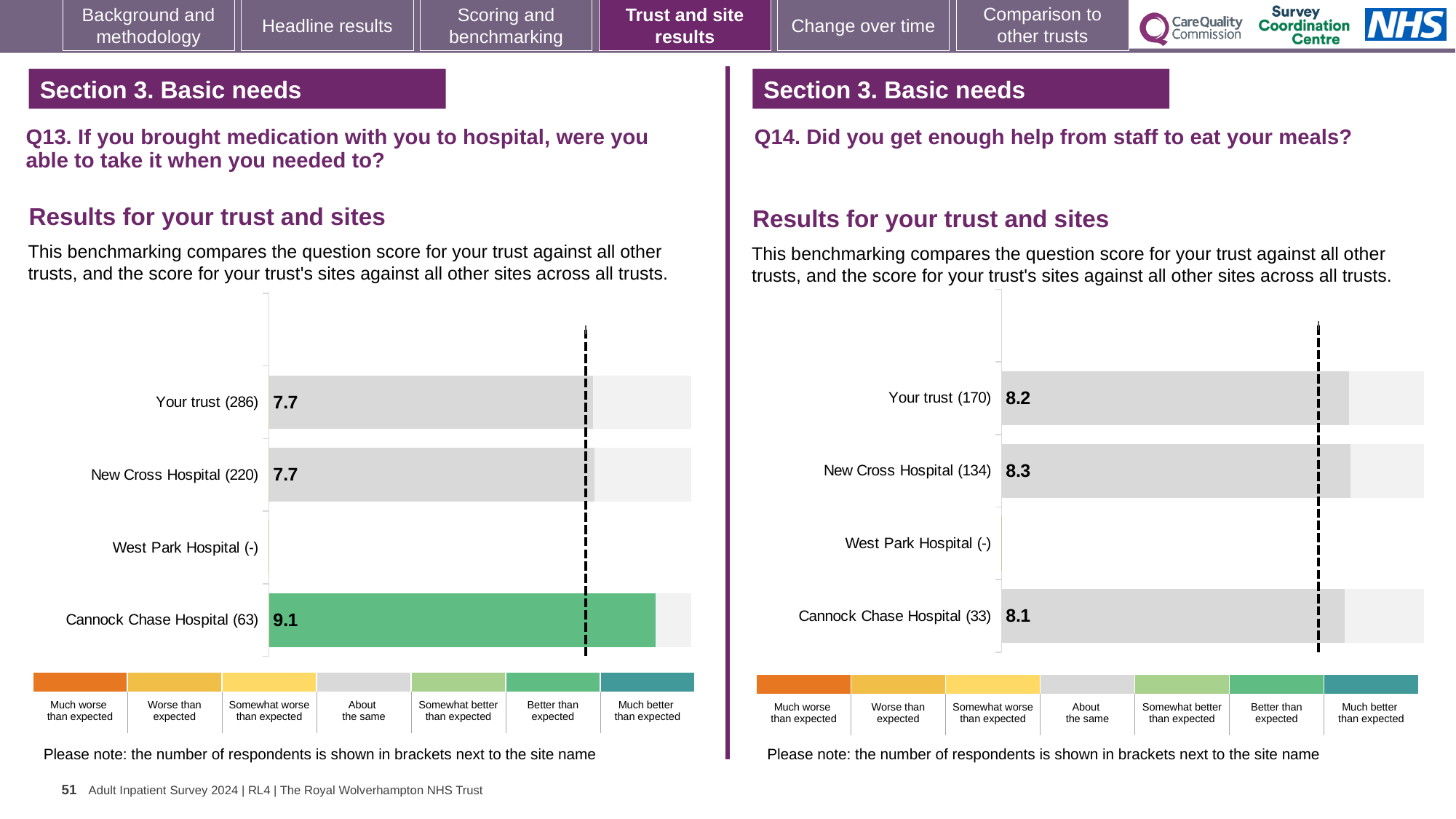
In the Q13 chart on the left, which site has the highest score? Cannock Chase Hospital In the Q13 chart on the left, what is the difference between the Cannock Chase Hospital score and the Your trust score? 1.4 In the Q14 chart on the right, what is the score for Cannock Chase Hospital? 8.1 In the Q14 chart on the right, how many respondents are shown in brackets for Your trust? 170 In the Q13 chart on the left, how many respondents are shown in brackets for New Cross Hospital? 220 In the Q13 chart on the left, which site's bar is coloured green, indicating 'Better than expected'? Cannock Chase Hospital In the Q13 chart on the left, what is the score for Cannock Chase Hospital? 9.1 In the Q14 chart on the right, is the score for Your trust higher or lower than the score for Cannock Chase Hospital? higher In the Q13 chart on the left, what is the score for Your trust? 7.7 What type of chart is used on the left for Q13? bar chart In the Q14 chart on the right, what is the score for New Cross Hospital? 8.3 In the Q14 chart on the right, what is the difference between the New Cross Hospital score and the Cannock Chase Hospital score? 0.2